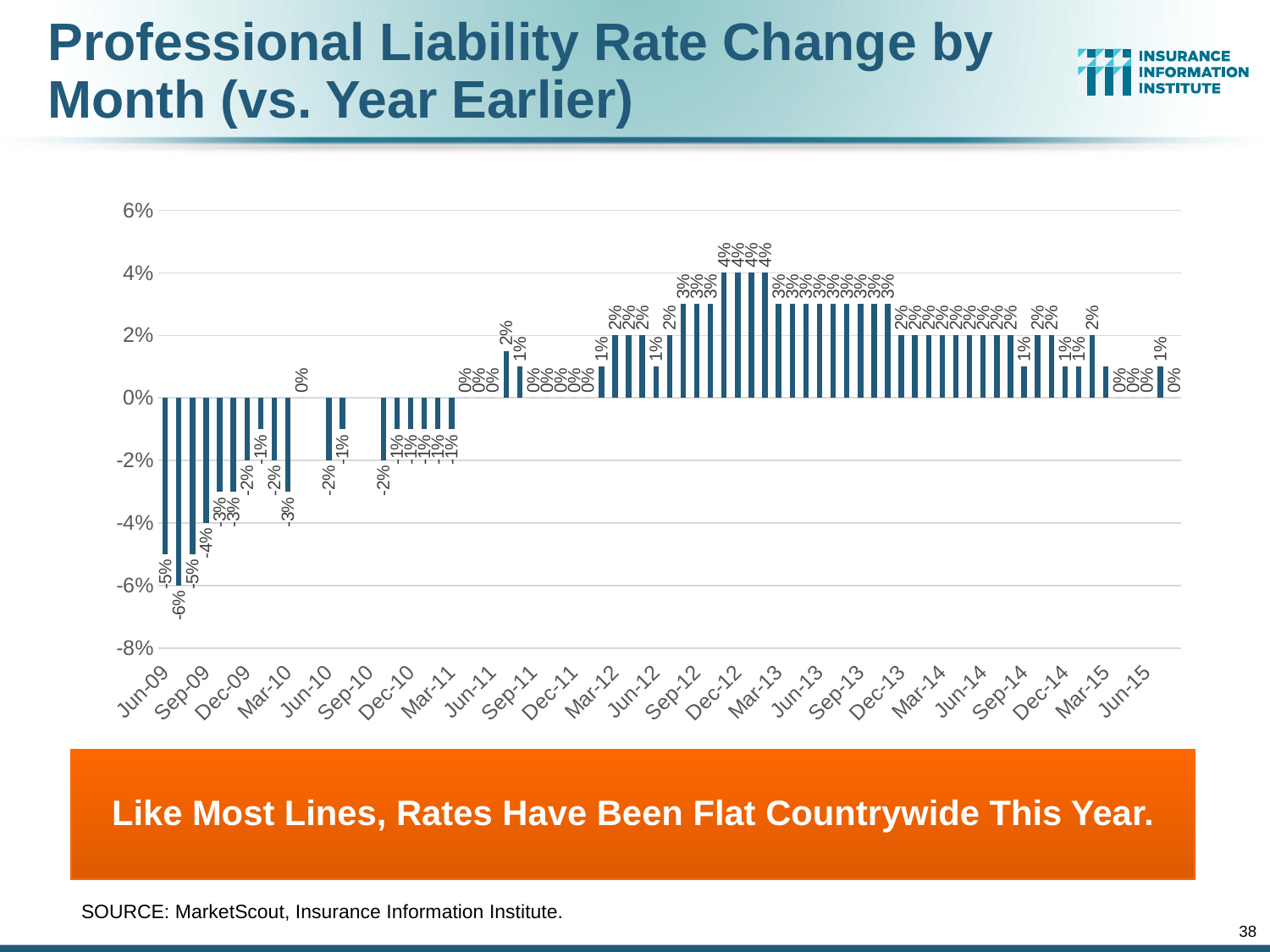
What is the rate change shown for Jun-09? -5% What is the lowest rate change value shown on the chart? -6% What is the rate change shown for Dec-12? 4% What kind of chart is shown on the slide? Bar chart Do the rate changes generally rise or fall from Jun-09 to Dec-12? Rise What is the rate change shown for Jun-15? 0% How many month labels are shown on the x axis? 25 What is the highest rate change value shown on the chart? 4% What is the title of the chart? Professional Liability Rate Change by Month (vs. Year Earlier) Which is larger, the rate change for Jun-09 or for Jun-15? Jun-15 What source is cited for the chart? MarketScout, Insurance Information Institute By how many percentage points does the Jun-15 value exceed the Jun-09 value? 5 percentage points